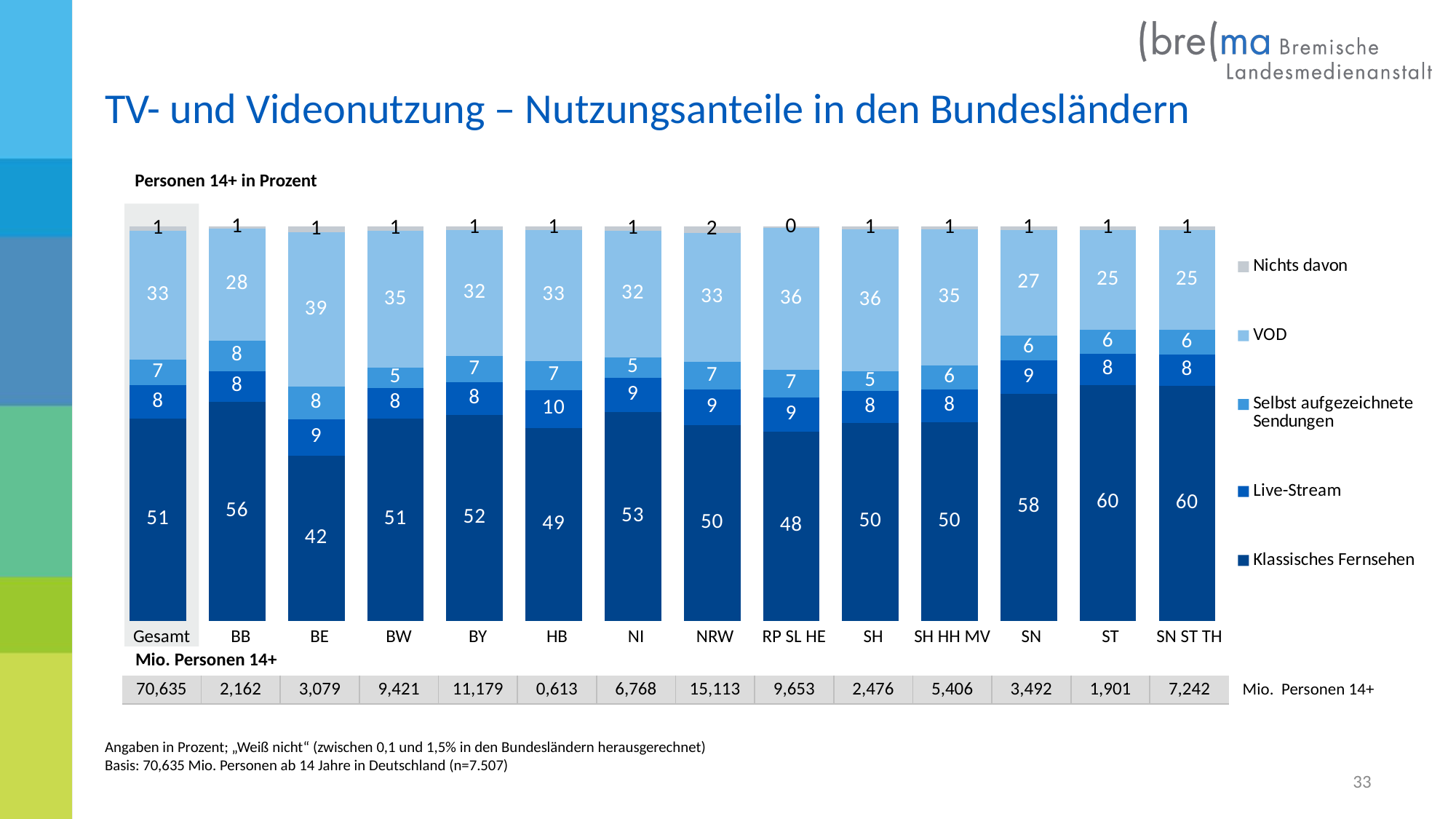
What is the total of the stacked bar for BW? 100 What is the Live-Stream value for HB? 10 What type of chart is shown on the slide? Stacked bar chart What is the difference between the Klassisches Fernsehen values for BB and BE? 14 Which category has the highest VOD value? BE What is the Klassisches Fernsehen value for BE? 42 How many categories (bars) are shown along the x axis? 14 Which category has the lowest Klassisches Fernsehen value? BE Which category has the highest Nichts davon value? NRW What is the VOD value for Gesamt? 33 How many series does the legend list? 5 Which is larger, the VOD value for SN or the VOD value for SH? SH